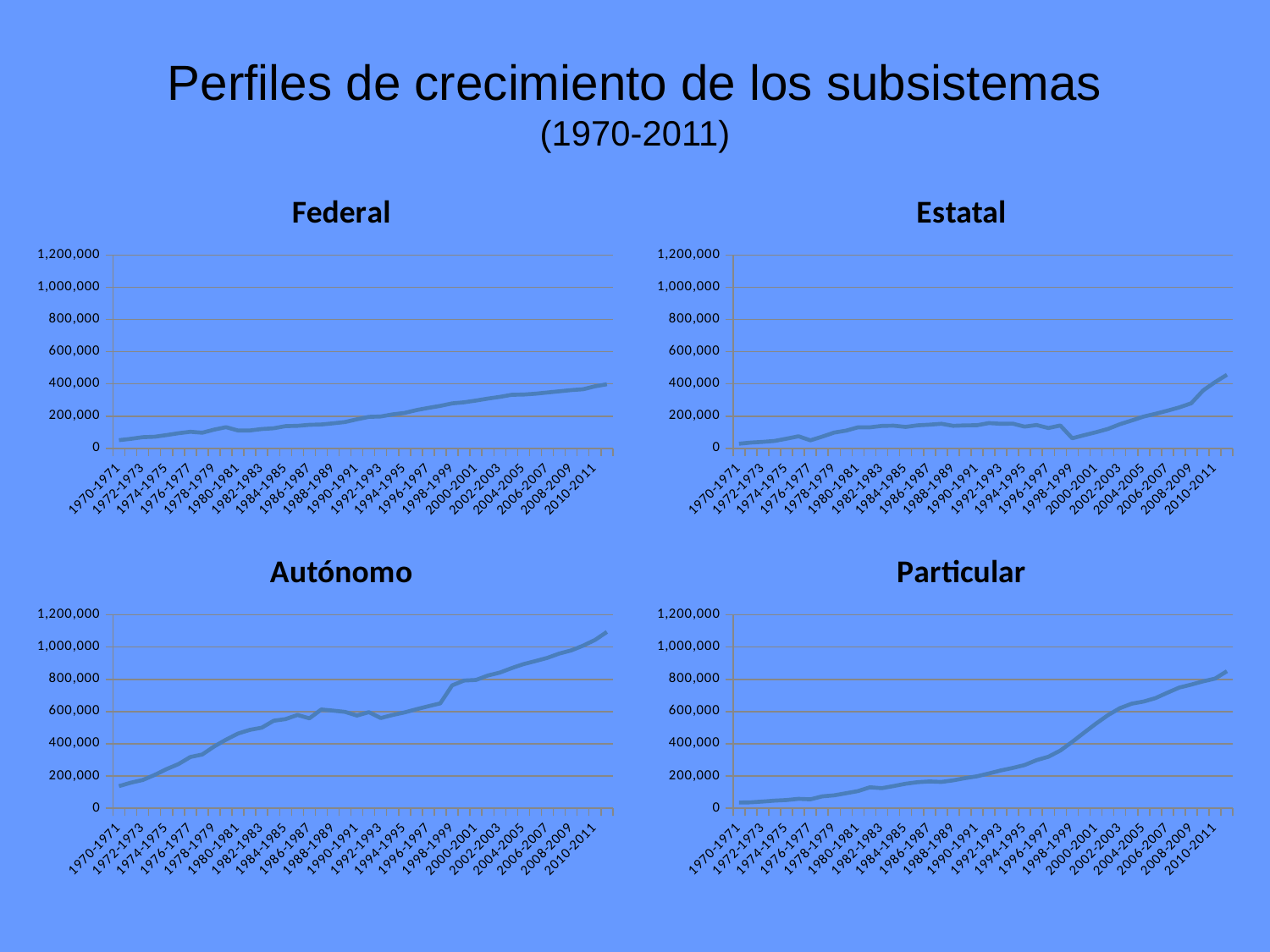
How many charts are shown on the slide? 4 Which chart reaches the highest value in 2010-2011: Autónomo or Particular? Autónomo In the Federal chart, is the value for 1970-1971 greater or less than 200,000? less In the Particular chart, do the values generally rise or fall along the x axis? rise In the Particular chart, is the value for 1970-1971 greater or less than 200,000? less What are the titles of the four charts on the slide? Federal, Estatal, Autónomo, Particular Which of the four charts reaches the highest value overall? Autónomo In the Autónomo chart, is the value for 2010-2011 greater or less than 1,000,000? greater What kind of chart is the Federal chart? line chart In the Autónomo chart, do the values generally rise or fall from 1970-1971 to 2010-2011? rise